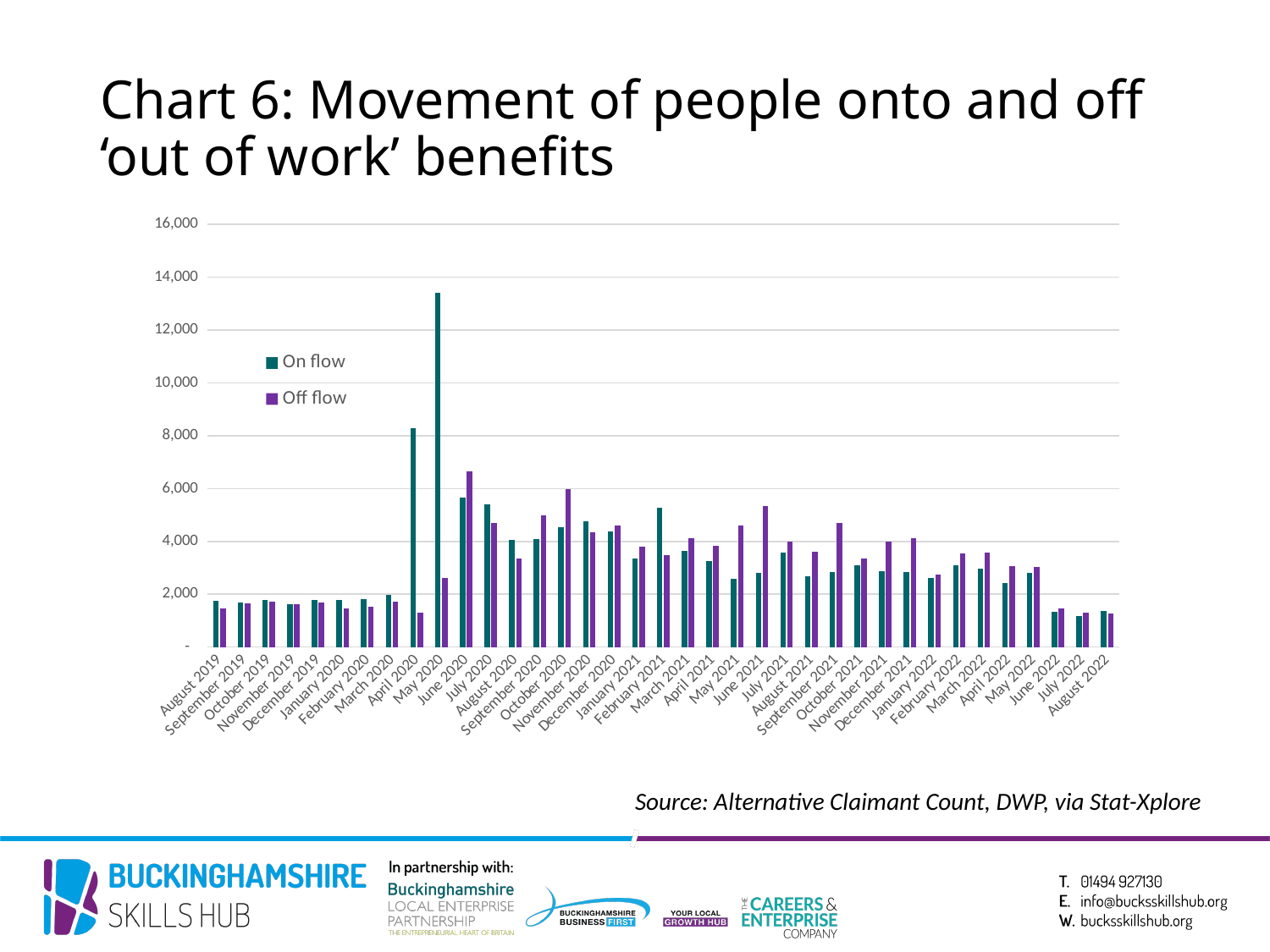
What are the two series named in the legend? On flow and Off flow In July 2020, which is larger: On flow or Off flow? On flow How many series does the legend list? 2 What kind of chart is shown on the slide? bar chart Is the On flow value for August 2019 greater or less than 2,000? less In which month is the Off flow value highest? June 2020 Is the Off flow value for June 2021 greater or less than 4,000? greater In which month is the On flow value highest? May 2020 How many months are shown along the x axis? 37 Is the On flow value for May 2020 greater or less than 12,000? greater In April 2020, which is larger: On flow or Off flow? On flow